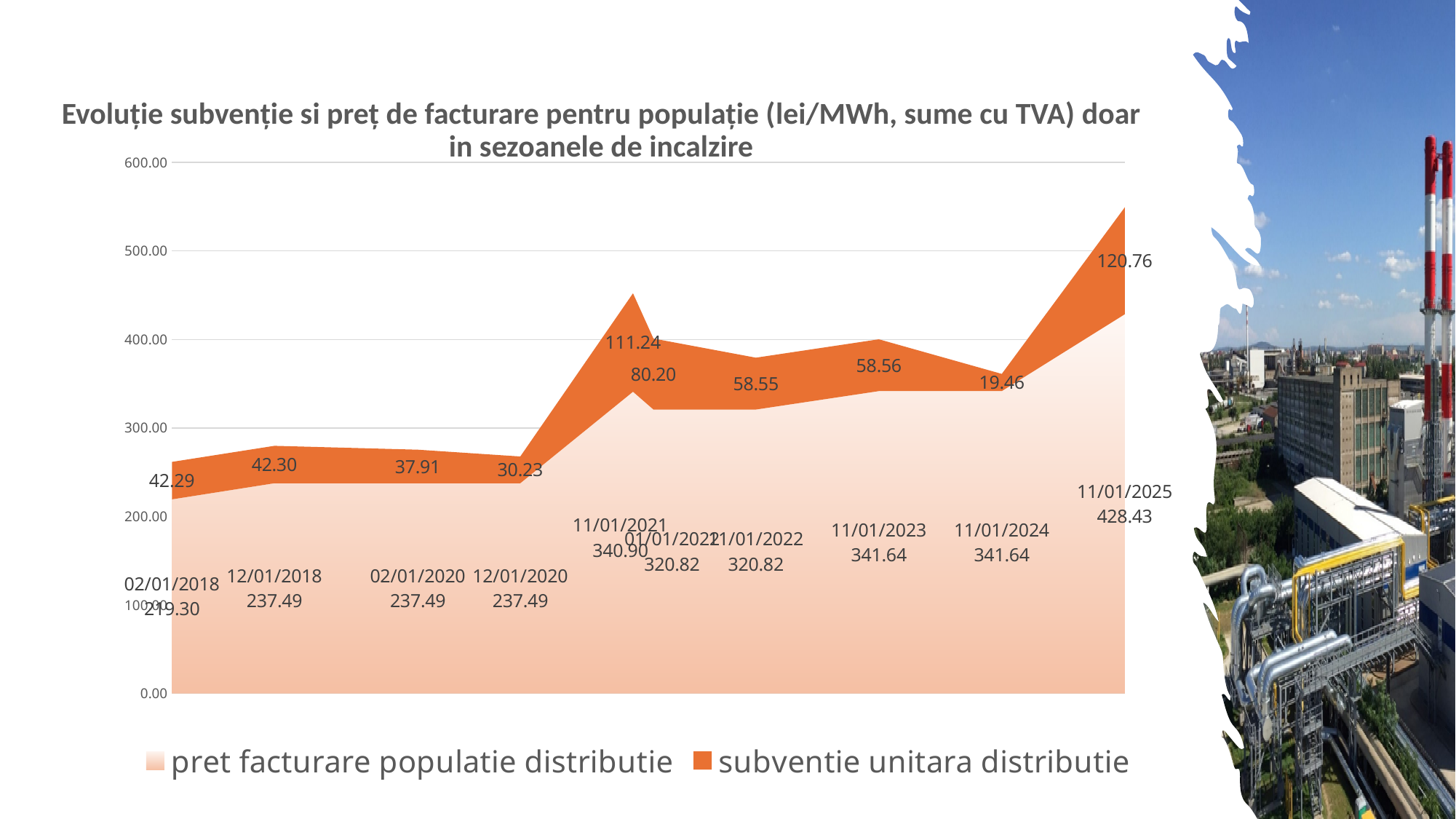
How many dates are plotted on the x axis? 10 What is the combined total of the two series at 11/01/2025? 549.19 Which is larger: 'subventie unitara distributie' at 11/01/2021 or at 01/01/2022? 11/01/2021 What is the value of 'subventie unitara distributie' at 11/01/2021? 111.24 At which date is 'subventie unitara distributie' lowest? 11/01/2024 What is the value of 'pret facturare populatie distributie' at 11/01/2025? 428.43 At which date is 'pret facturare populatie distributie' lowest? 02/01/2018 At which date is 'subventie unitara distributie' highest? 11/01/2025 What is the difference between 'pret facturare populatie distributie' at 11/01/2025 and at 11/01/2024? 86.79 How many series does the legend list? 2 What is the value of 'subventie unitara distributie' at 11/01/2024? 19.46 What kind of chart is shown? Area chart